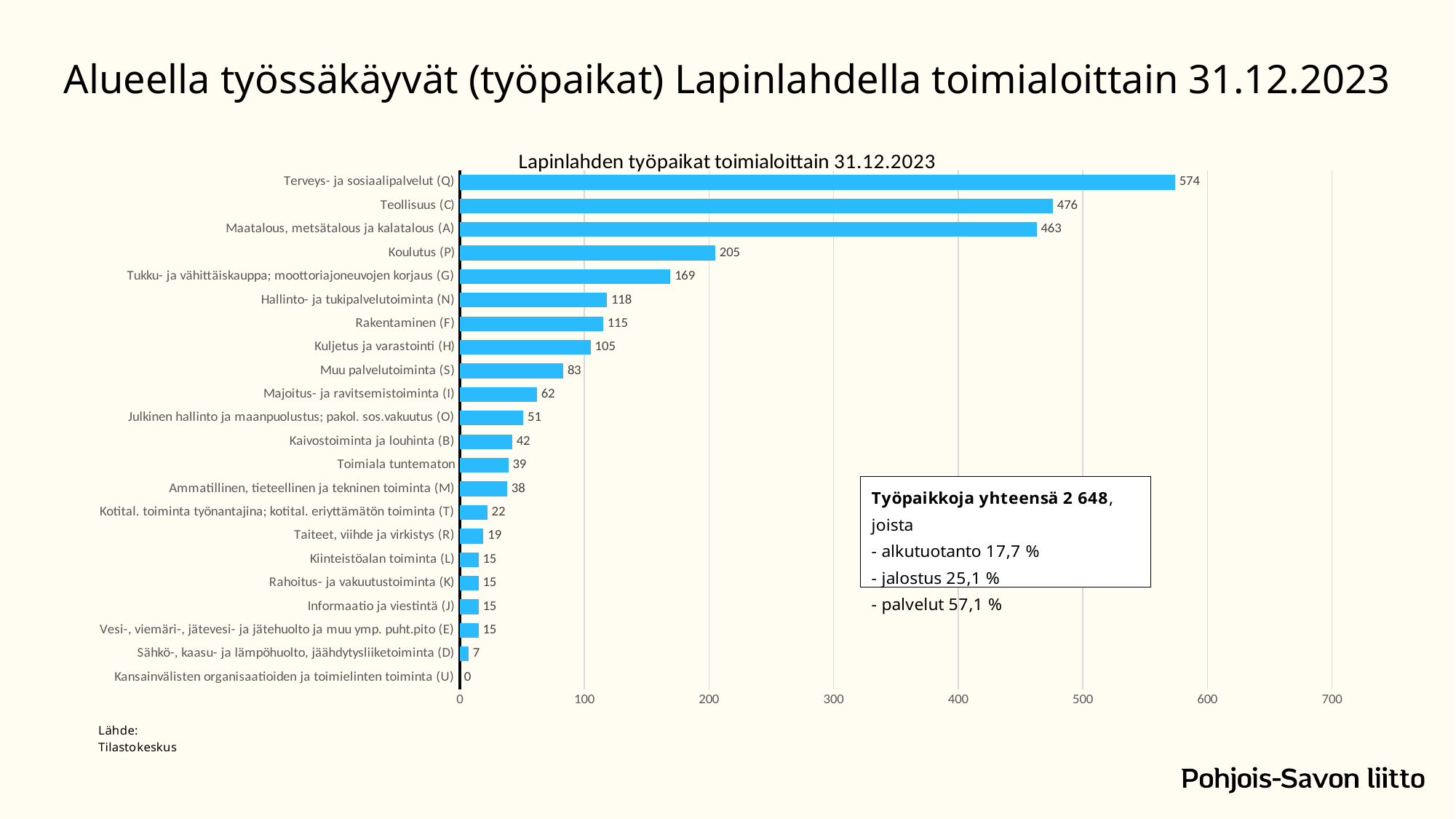
Which category has the highest value? Terveys- ja sosiaalipalvelut (Q) How many categories are shown in the chart? 22 Which category has the lowest value? Kansainvälisten organisaatioiden ja toimielinten toiminta (U) What is the value for Kuljetus ja varastointi (H)? 105 What is the value for Terveys- ja sosiaalipalvelut (Q)? 574 What is the difference between Teollisuus (C) and Maatalous, metsätalous ja kalatalous (A)? 13 What kind of chart is shown on the slide? bar chart Which is larger, Hallinto- ja tukipalvelutoiminta (N) or Rakentaminen (F)? Hallinto- ja tukipalvelutoiminta (N) Is the value for Tukku- ja vähittäiskauppa; moottoriajoneuvojen korjaus (G) greater or less than 200? less What is the value for Koulutus (P)? 205 What is the title of the chart? Lapinlahden työpaikat toimialoittain 31.12.2023 What is the value for Sähkö-, kaasu- ja lämpöhuolto, jäähdytysliiketoiminta (D)? 7